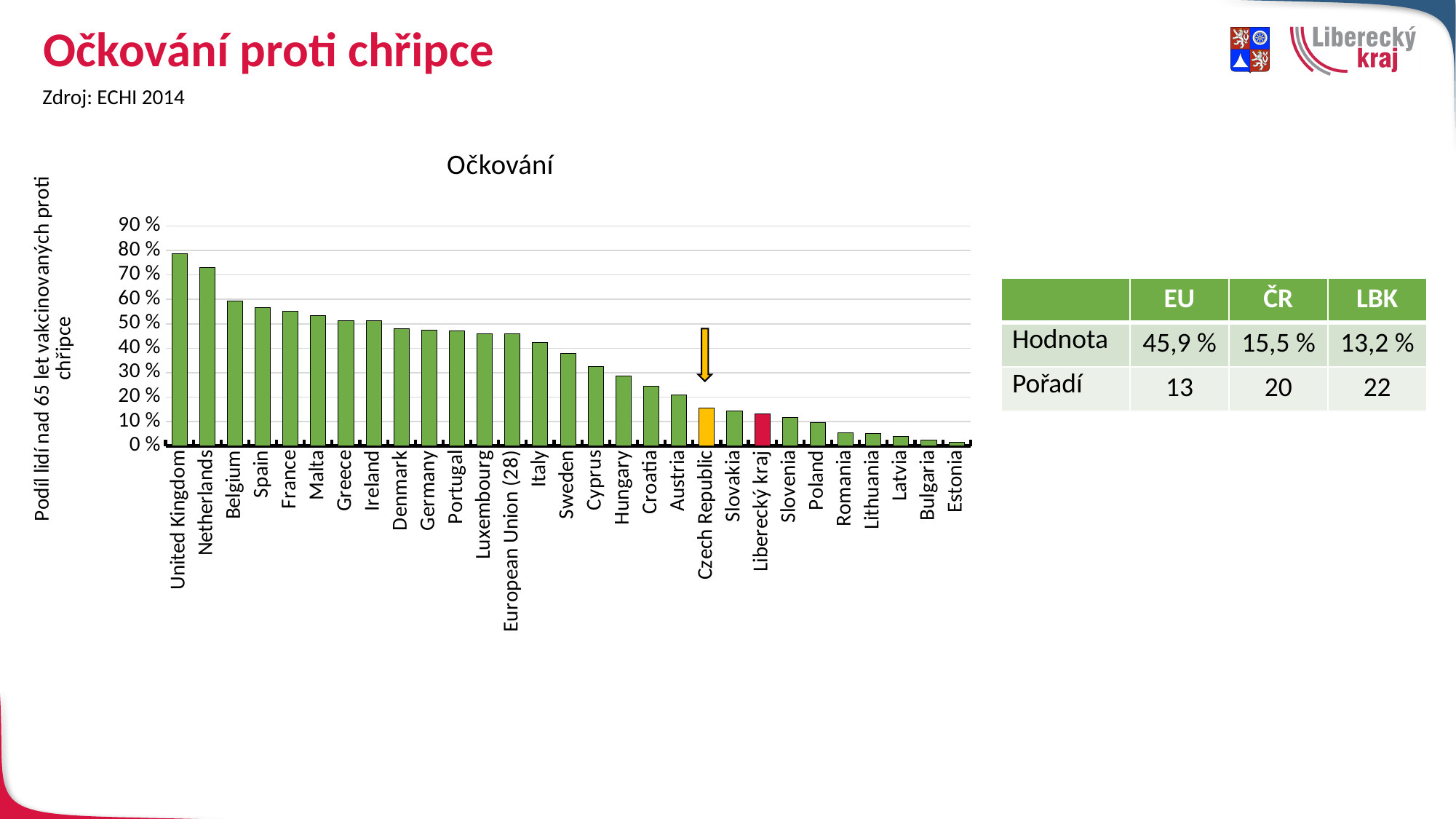
Is the value for Germany greater or less than 50 %? less Is the value for Romania greater or less than 10 %? less What kind of chart is shown on the slide? bar chart Is the value for Spain greater or less than 50 %? greater What is the title of the chart? Očkování Which category has the lowest value in the chart? Estonia Which has the larger value, United Kingdom or Netherlands? United Kingdom How many categories (bars) are plotted in the chart? 29 What colour is the bar for Liberecký kraj? red Which category has the highest value in the chart? United Kingdom Do the values rise or fall from left to right along the x axis? fall